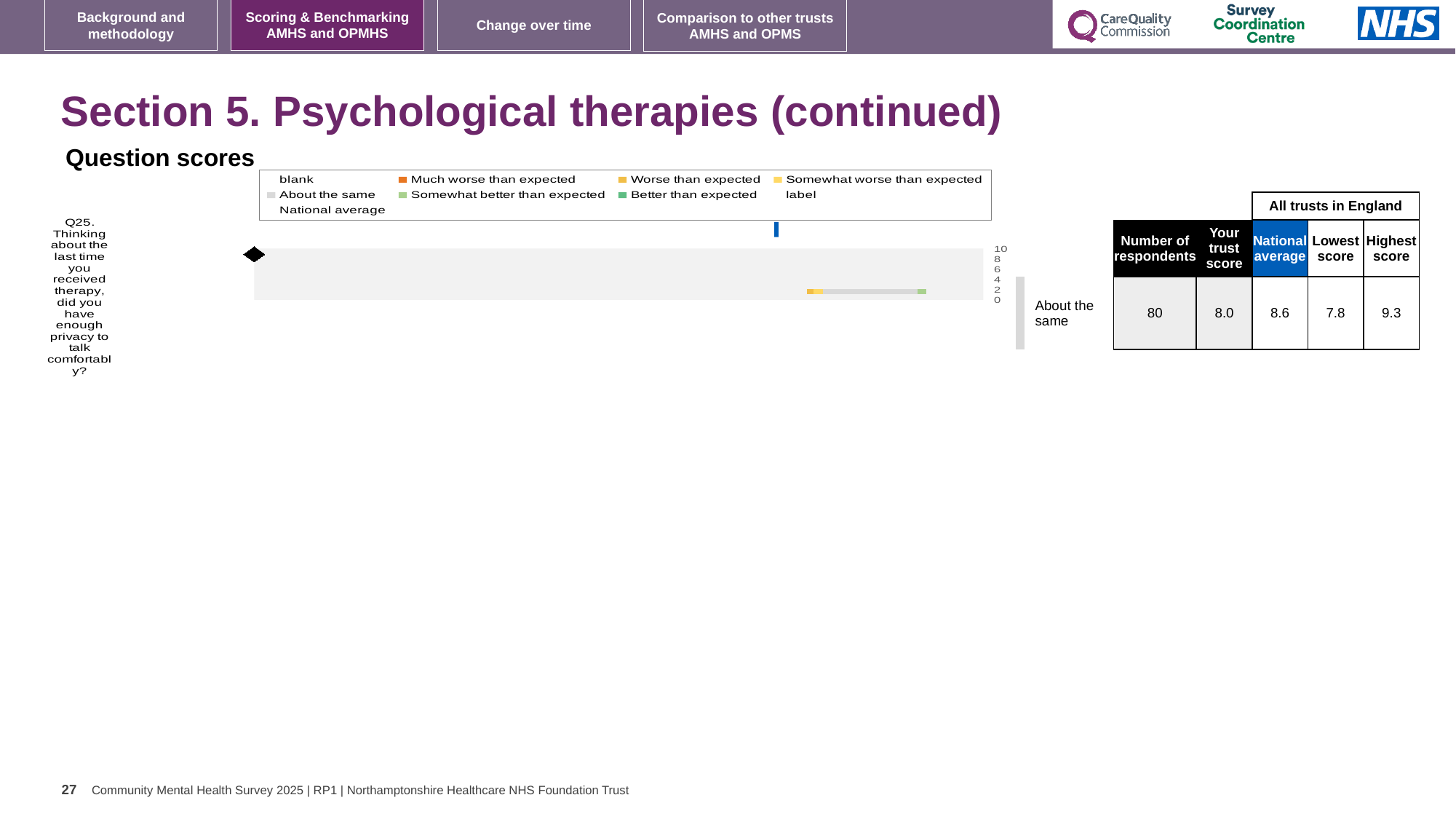
Which question number is plotted in the chart? Q25 What colour is the legend marker for 'Better than expected'? green In the table beside the chart, which is larger for Q25: your trust score or the national average? National average In the table beside the chart, what is the number of respondents for Q25? 80 What is the highest value shown on the chart's numeric axis? 10 What kind of chart is shown under 'Question scores'? bar chart In the table beside the chart, what is the national average for Q25? 8.6 In the table beside the chart, what is the difference between the highest score and the lowest score for Q25? 1.5 What benchmark category label is shown next to the chart for Q25? About the same How many survey questions are plotted in the chart? 1 In the table beside the chart, what is the lowest score among all trusts in England for Q25? 7.8 In the table beside the chart, what is 'Your trust score' for Q25? 8.0